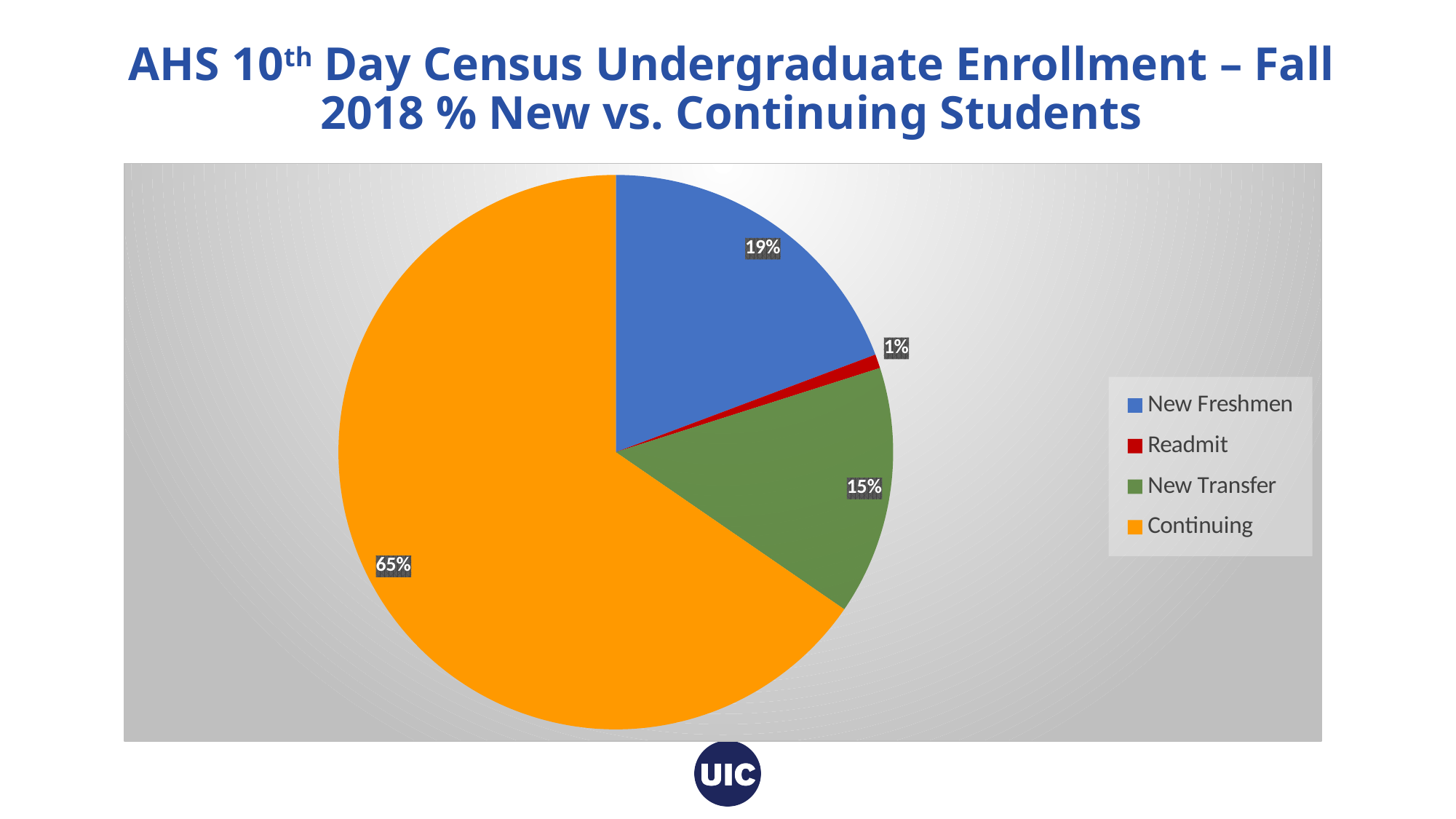
What percentage of students are Continuing? 65% What percentage of students are New Freshmen? 19% Which is larger, the share for New Freshmen or the share for New Transfer? New Freshmen What colour represents Continuing students in the chart? Orange Which category has the largest share of the pie? Continuing How many categories does the pie chart show? 4 What type of chart is shown on the slide? Pie chart What percentage of students are Readmit? 1% What percentage of students are New Transfer? 15% What is the difference in percentage points between Continuing and New Freshmen? 46 What is the combined share of New Freshmen and New Transfer students? 34% Which category has the smallest share of the pie? Readmit